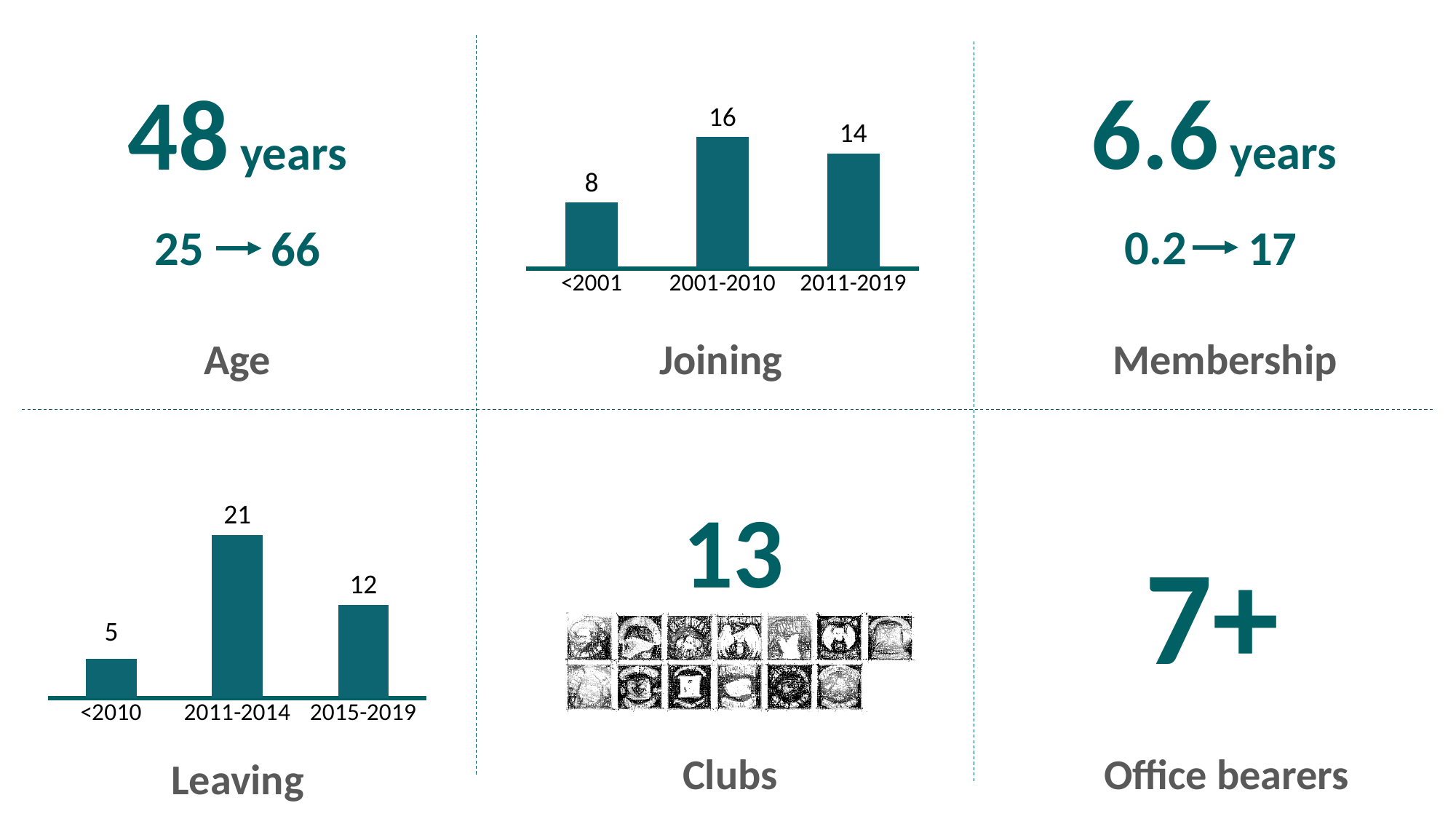
In the Joining chart, which category has the highest value? 2001-2010 In the Leaving chart, what is the value for 2015-2019? 12 In the Joining chart, how many categories are shown? 3 In the Joining chart, what is the difference between the values for 2001-2010 and 2011-2019? 2 In the Leaving chart, what is the value for 2011-2014? 21 What kind of chart is the Leaving chart? Bar chart In the Leaving chart, what is the difference between the values for 2011-2014 and <2010? 16 In the Leaving chart, which category has the lowest value? <2010 In the Leaving chart, which is larger: the value for 2011-2014 or the value for 2015-2019? 2011-2014 In the Joining chart, which category has the lowest value? <2001 In the Joining chart, what is the value for 2001-2010? 16 In the Joining chart, what is the value for <2001? 8